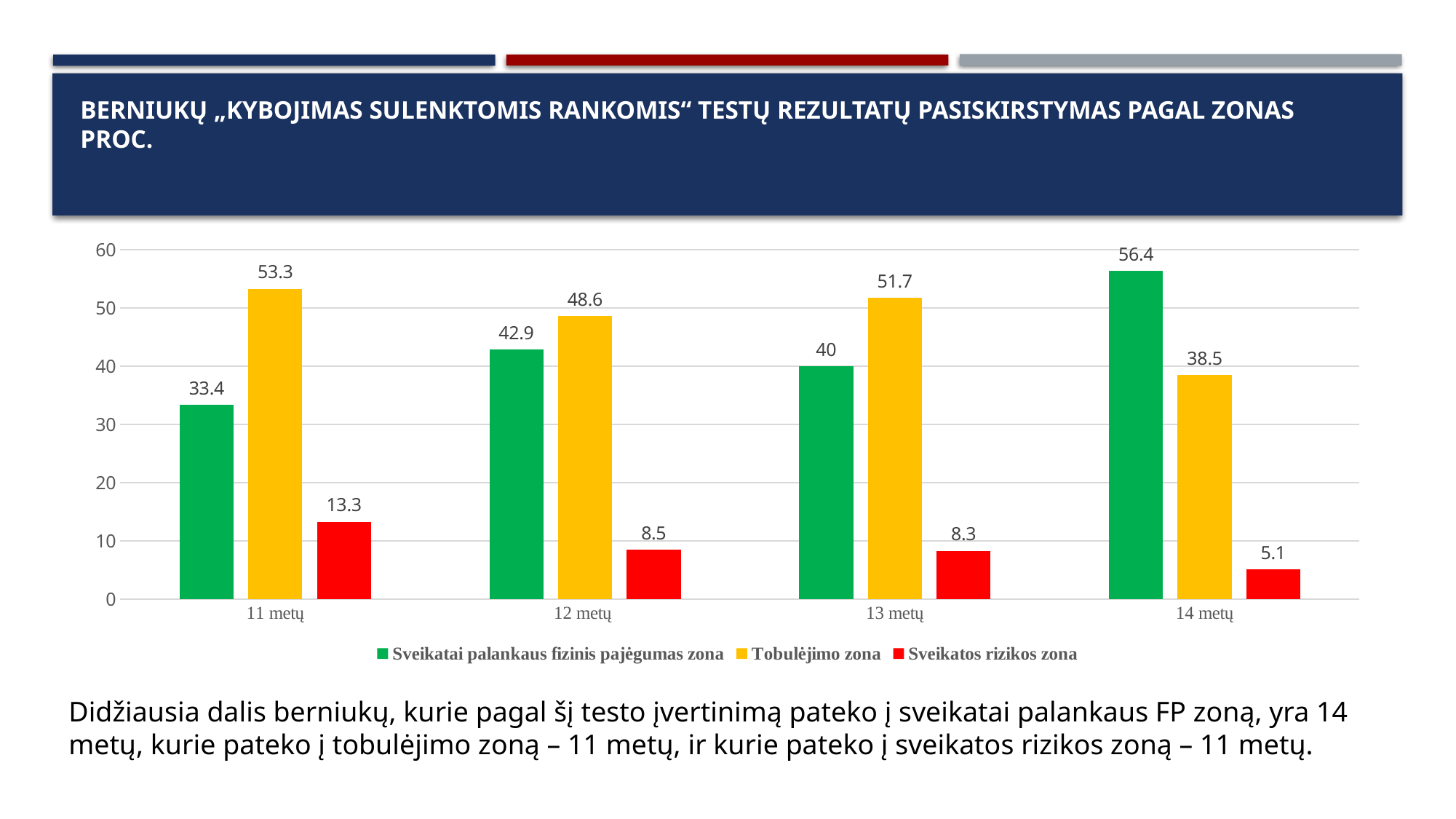
What is the value for 'Sveikatai palankaus fizinis pajėgumas zona' at 14 metų? 56.4 What is the value for 'Sveikatos rizikos zona' at 12 metų? 8.5 What is the difference between the 'Tobulėjimo zona' values at 11 metų and 14 metų? 14.8 Which is larger at 13 metų: 'Sveikatai palankaus fizinis pajėgumas zona' or 'Tobulėjimo zona'? Tobulėjimo zona How many series does the legend list? 3 What kind of chart is shown on the slide? Bar chart What colour represents 'Tobulėjimo zona' in the chart? Yellow Which age group has the lowest value for 'Sveikatai palankaus fizinis pajėgumas zona'? 11 metų Do the values for 'Sveikatos rizikos zona' rise or fall from 11 metų to 14 metų? Fall Which age group has the highest value for 'Sveikatos rizikos zona'? 11 metų How many age groups are shown on the x axis? 4 What is the value for 'Tobulėjimo zona' at 11 metų? 53.3